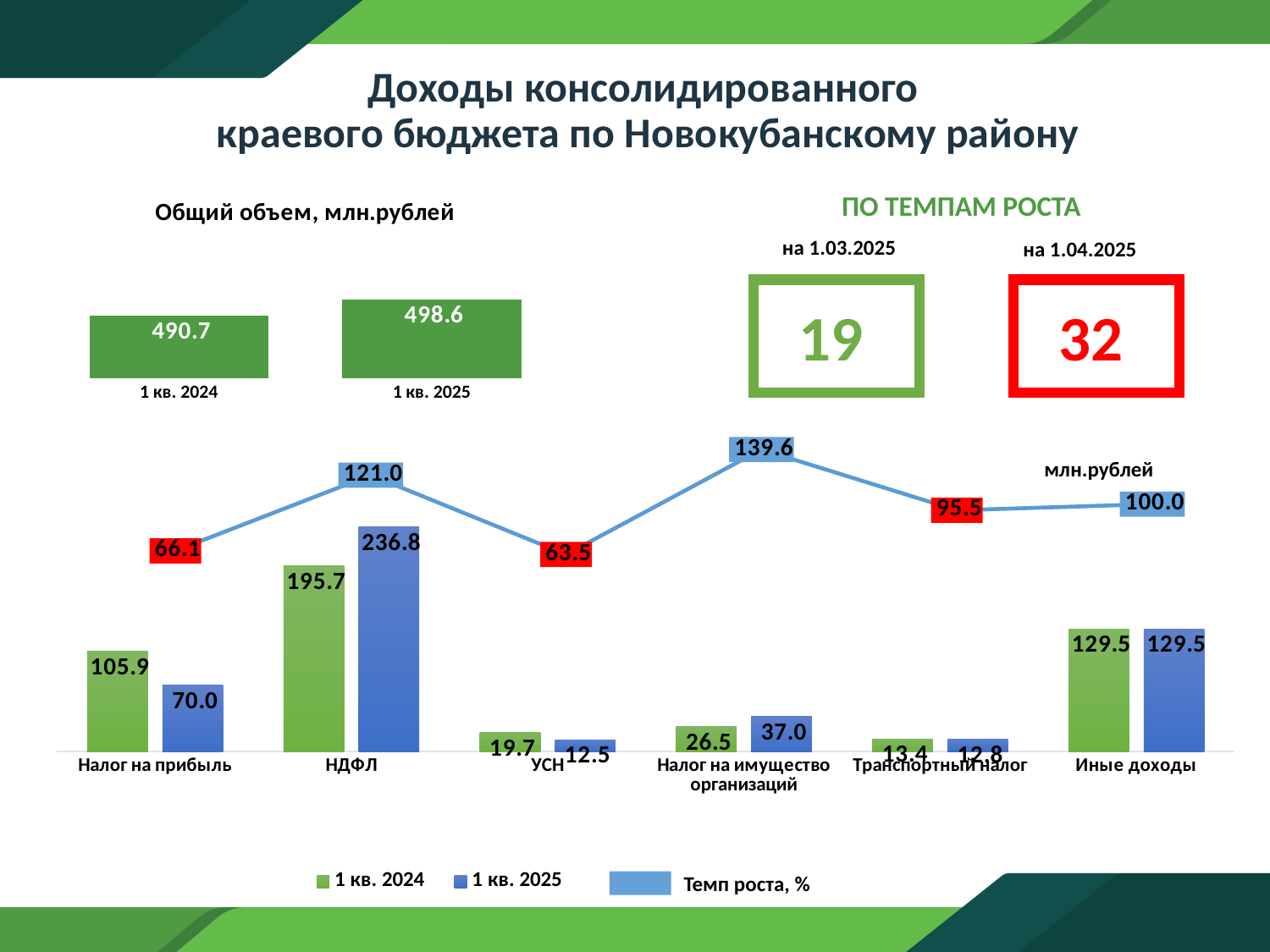
What is the difference between the 1 кв. 2025 and 1 кв. 2024 values for Налог на имущество организаций? 10.5 Which category has the lowest Темп роста, % value? УСН How many categories are shown on the x axis of the chart? 6 Which category has the highest value in the 1 кв. 2025 series? НДФЛ What is the Темп роста, % value for Иные доходы? 100.0 What is the difference between the 1 кв. 2025 and 1 кв. 2024 values for НДФЛ? 41.1 Which is larger for Налог на прибыль: the 1 кв. 2024 value or the 1 кв. 2025 value? 1 кв. 2024 What is the Темп роста, % value for Налог на имущество организаций? 139.6 What is the value for НДФЛ in the 1 кв. 2025 series? 236.8 How many series does the chart legend list? 3 What kind of chart is used for the 1 кв. 2024 and 1 кв. 2025 series? Bar chart What is the value for Налог на прибыль in the 1 кв. 2024 series? 105.9